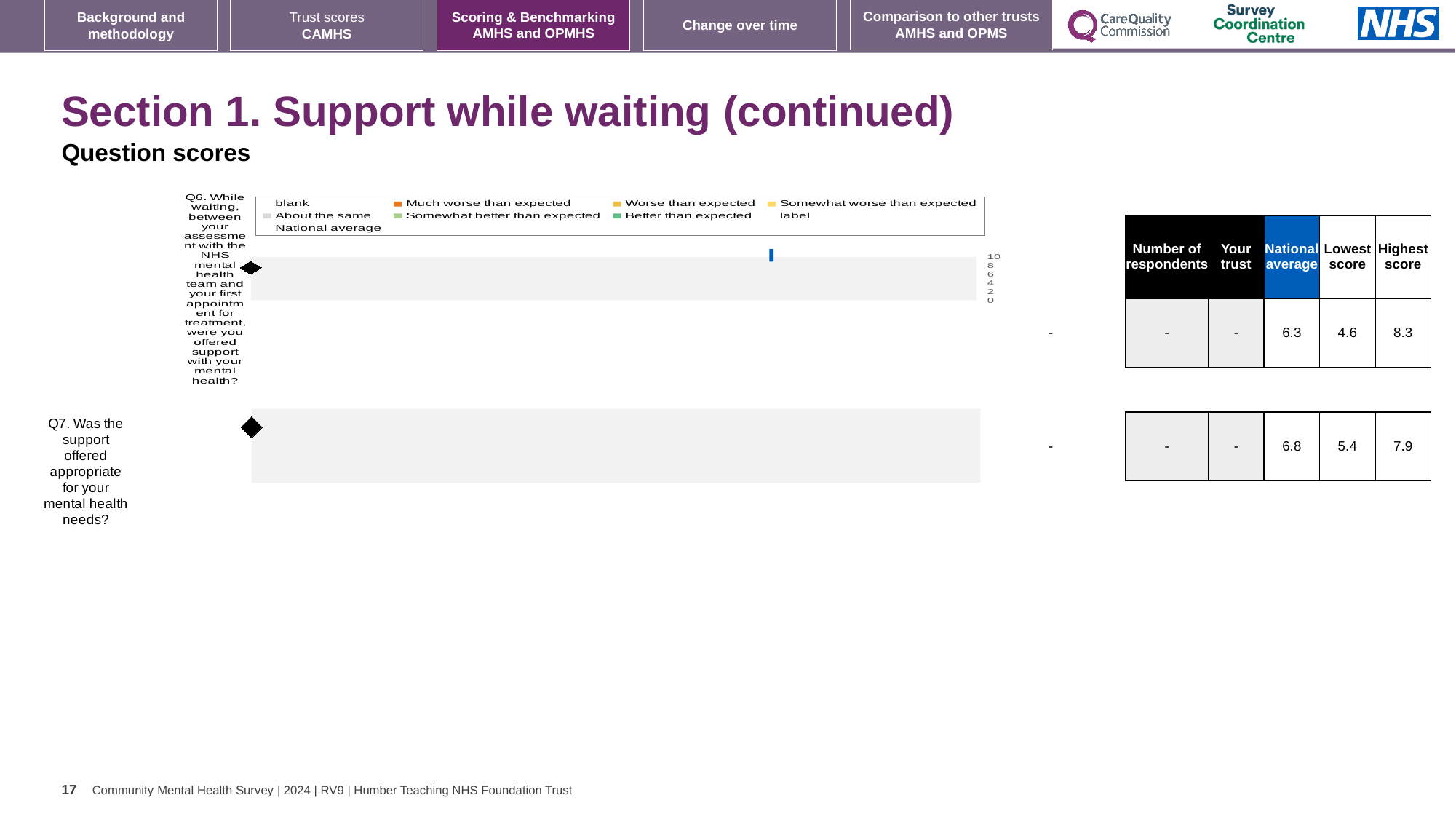
In the table beside the chart, what is the Lowest score for Q6? 4.6 What is the difference between the Highest score and the Lowest score for Q7? 2.5 What value is shown in the 'Your trust' column for Q6? - In the table beside the chart, what is the Highest score for Q7? 7.9 In the table beside the chart, what is the National average score for Q6? 6.3 Which question has the higher National average score, Q6 or Q7? Q7 How many entries does the chart legend list? 9 What kind of chart is shown on the slide? bar chart In the table beside the chart, what is the National average score for Q7? 6.8 How many survey questions (categories) are plotted in the chart? 2 What is the difference between the Highest score and the Lowest score for Q6? 3.7 What is the highest tick value shown on the chart's score axis? 10